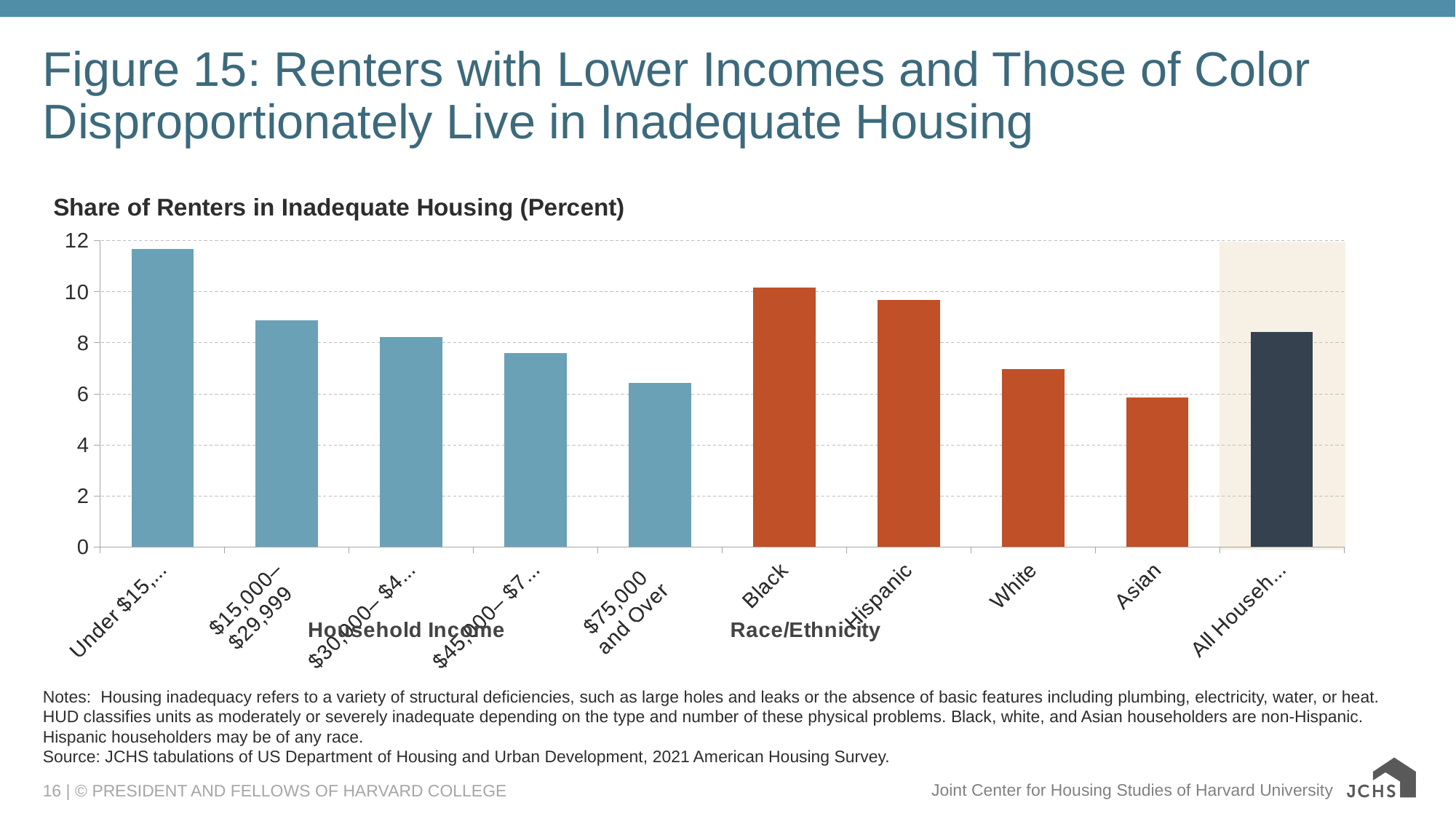
How many bars are plotted in the chart? 10 Across the Household Income groups from lowest to highest income, do the values rise or fall? Fall Among the Race/Ethnicity groups, which has the highest share of renters in inadequate housing? Black What kind of chart is shown on the slide? Bar chart Is the value for Black greater or less than 8? greater Among the Race/Ethnicity groups, which has the lowest share of renters in inadequate housing? Asian Is the value for White greater or less than 8? less Which is larger, the value for $15,000–$29,999 or the value for $75,000 and Over? $15,000–$29,999 Is the value for $15,000–$29,999 greater or less than 8? greater What is the title of the chart? Share of Renters in Inadequate Housing (Percent) Which is larger, the value for Black or the value for White? Black